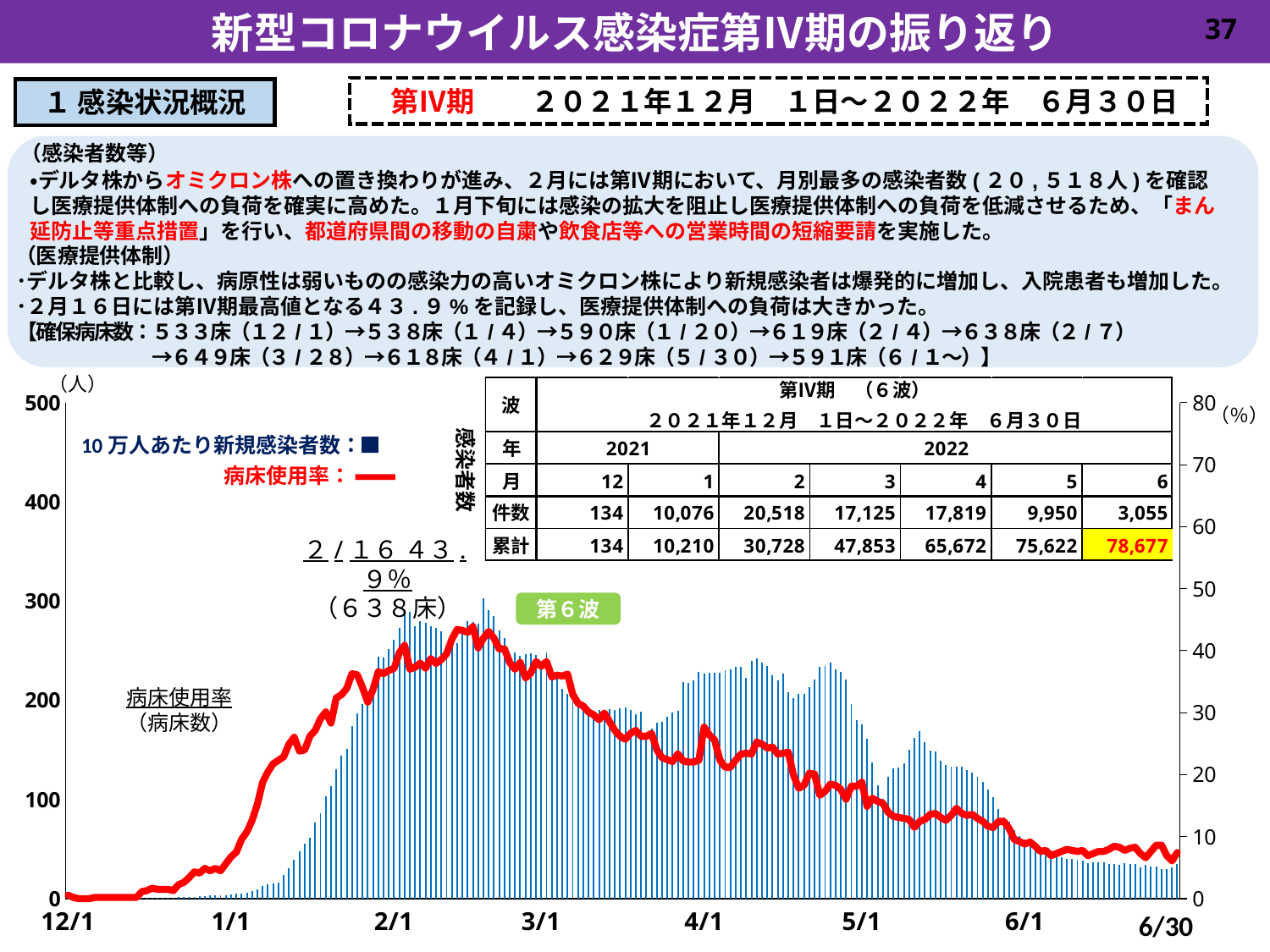
In the table on the chart, what is the 累計 (cumulative) value for month 6 of 2022? 78,677 What was the peak bed occupancy rate (病床使用率) annotated on the chart, and on what date? 43.9% on 2/16 How many beds (病床数) are noted at the 2/16 peak annotation on the chart? 638床 What does the blue bar series in the chart represent? 10万人あたり新規感染者数 Is the bed occupancy rate (red line) at 1/1 greater or less than 10%? less Does the bed occupancy rate (red line) rise or fall between 2/16 and 6/30? fall What does the red line in the chart represent? 病床使用率 In the table on the chart, which month has the highest 件数 (monthly case count)? 2 (2022年2月), 20,518 What kind of chart is shown at the bottom of the slide? A combined bar and line chart In the table on the chart, what is the difference between the 件数 for month 2 and month 3 of 2022? 3,393 Is the bed occupancy rate (red line) at 6/30 greater or less than 10%? less How many series does the chart legend list? 2